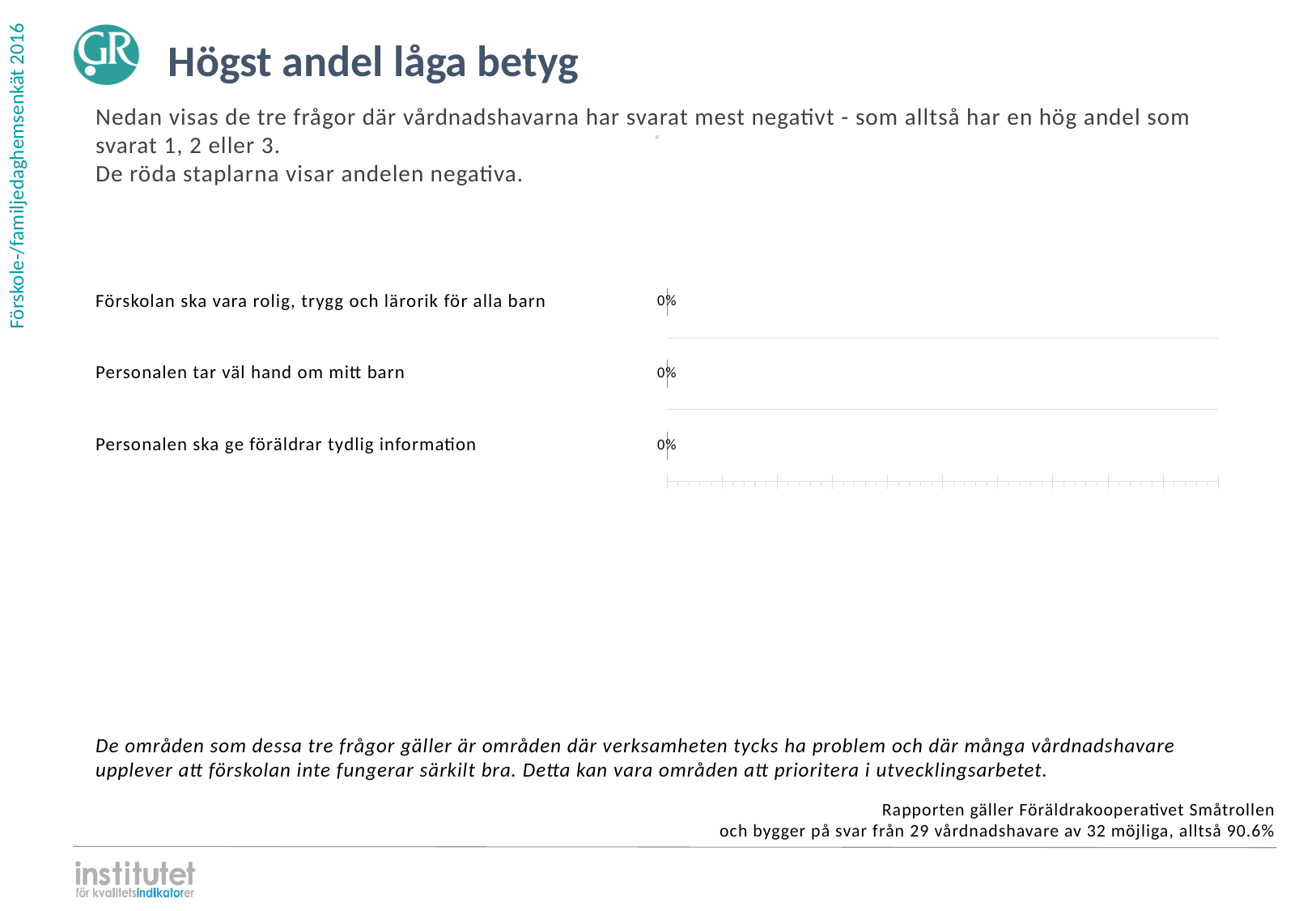
What is the value shown for "Personalen tar väl hand om mitt barn"? 0% What is the value shown for "Personalen ska ge föräldrar tydlig information"? 0% What is the title of the slide containing the chart? Högst andel låga betyg Is the value for "Förskolan ska vara rolig, trygg och lärorik för alla barn" greater than 0%? No According to the slide text, what do the red bars show? Andelen negativa Do all three categories in the chart have the same value? Yes How many categories (questions) are plotted in the chart? 3 What is the difference between the values for "Personalen tar väl hand om mitt barn" and "Personalen ska ge föräldrar tydlig information"? 0% What is the value shown for "Förskolan ska vara rolig, trygg och lärorik för alla barn"? 0% What kind of chart is shown on the slide? Bar chart